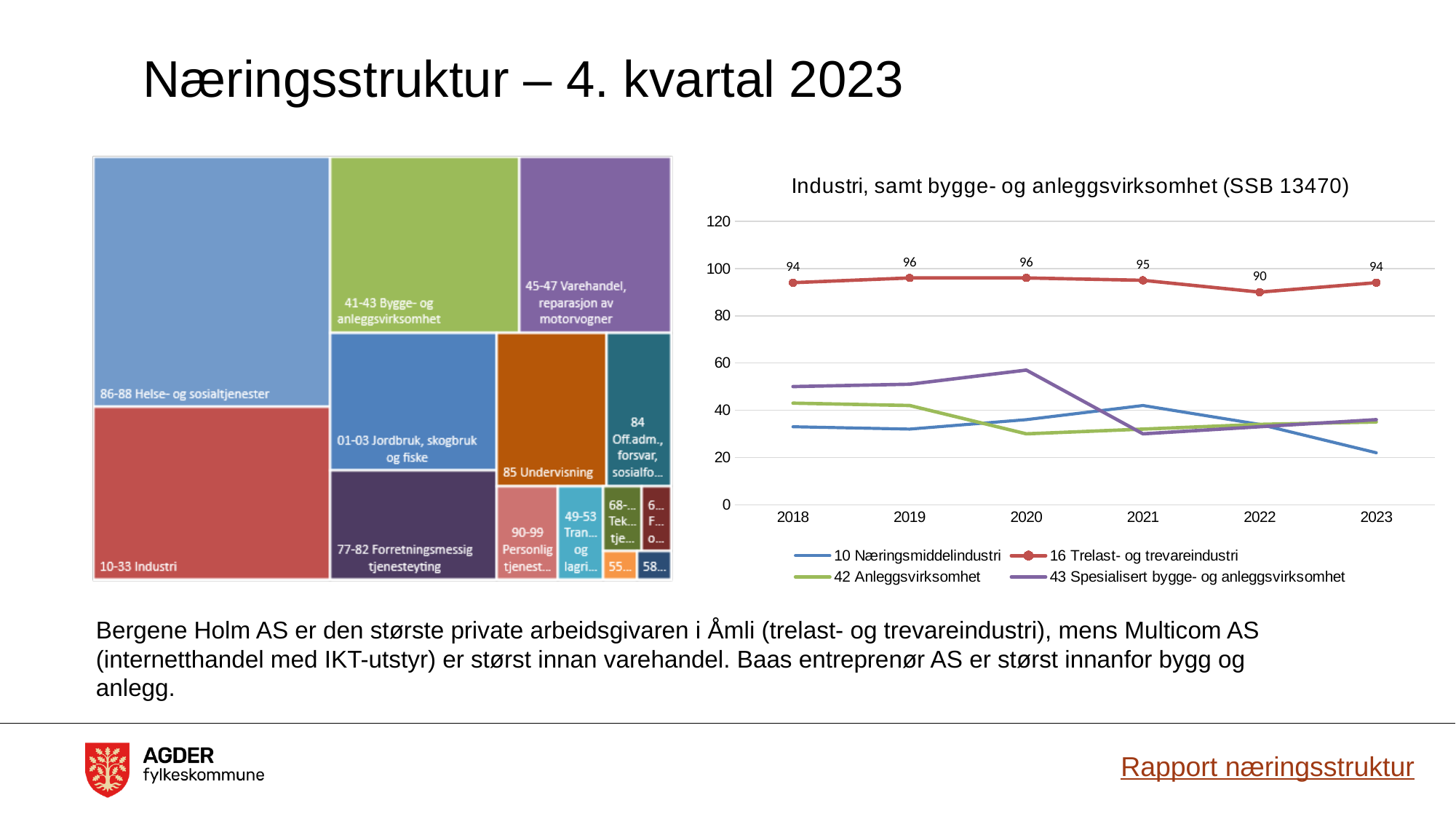
In the line chart on the right, is the value for 10 Næringsmiddelindustri in 2023 greater or less than 40? less In the line chart on the right, does the value for 10 Næringsmiddelindustri rise or fall from 2021 to 2023? fall In the treemap on the left, which category occupies the largest area? 86-88 Helse- og sosialtjenester How many years are shown on the x axis of the line chart on the right? 6 In the line chart on the right, in which year is the value for 16 Trelast- og trevareindustri lowest? 2022 In the line chart 'Industri, samt bygge- og anleggsvirksomhet (SSB 13470)', what is the value for 16 Trelast- og trevareindustri in 2018? 94 What kind of chart is the chart on the right of the slide? line chart In the line chart on the right, is the value for 43 Spesialisert bygge- og anleggsvirksomhet in 2020 greater or less than 40? greater In the line chart on the right, what is the value for 16 Trelast- og trevareindustri in 2022? 90 In the line chart on the right, what is the difference between the 2019 and 2022 values for 16 Trelast- og trevareindustri? 6 In the line chart on the right, which series has the higher value in 2021: 10 Næringsmiddelindustri or 42 Anleggsvirksomhet? 10 Næringsmiddelindustri How many series does the legend of the line chart on the right list? 4